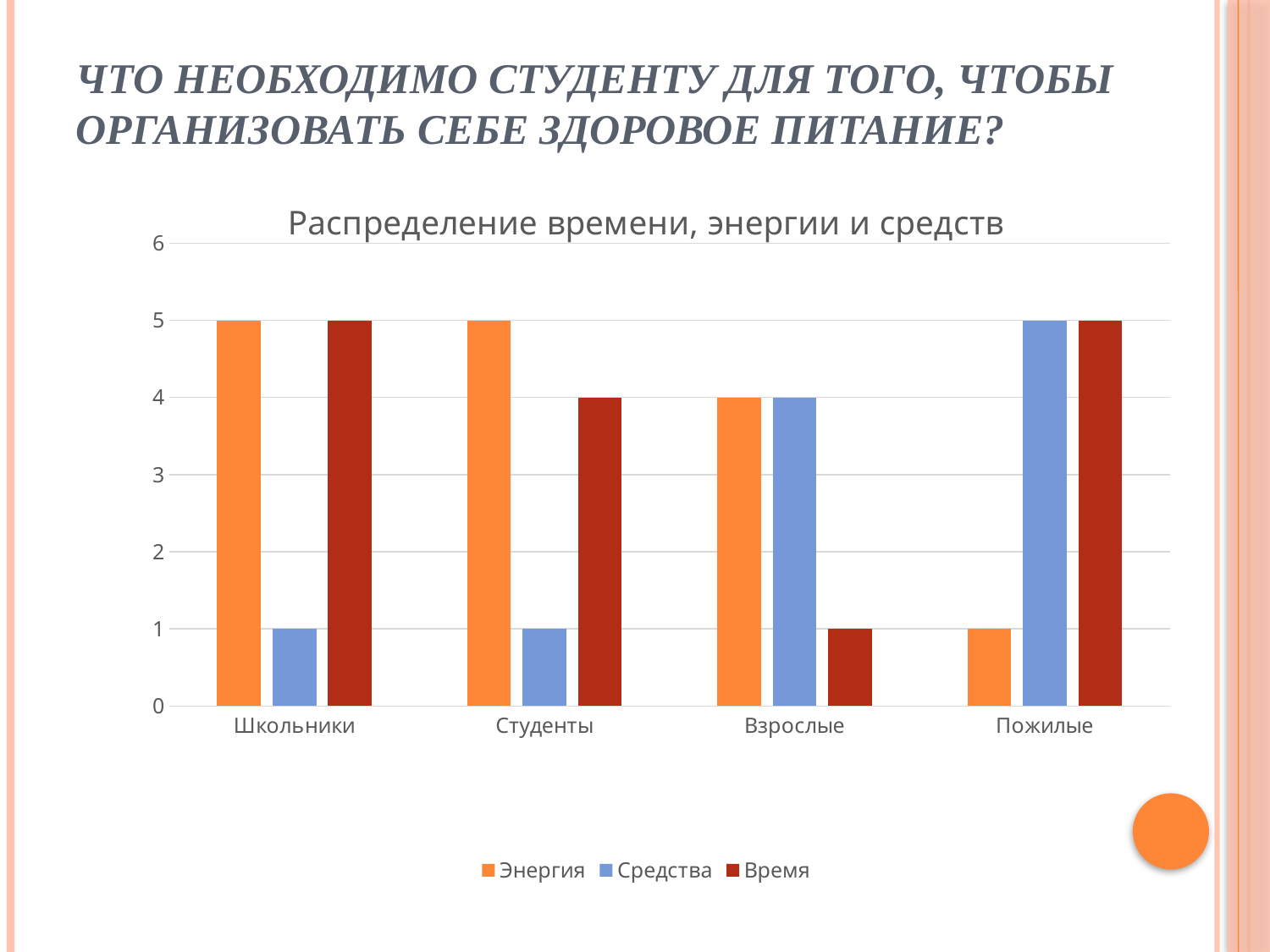
How many series does the legend list? 3 What is the value of Средства for Пожилые? 5 How many categories are shown on the x axis? 4 What kind of chart is shown on the slide? Bar chart What is the difference between Время for Студенты and Время for Взрослые? 3 What is the value of Энергия for Школьники? 5 What is the value of Время for Взрослые? 1 Which category has the lowest value for Время? Взрослые What is the title of the chart? Распределение времени, энергии и средств What is the value of Средства for Студенты? 1 Which is larger: Энергия for Взрослые or Энергия for Пожилые? Энергия for Взрослые Which category has the lowest value for Энергия? Пожилые